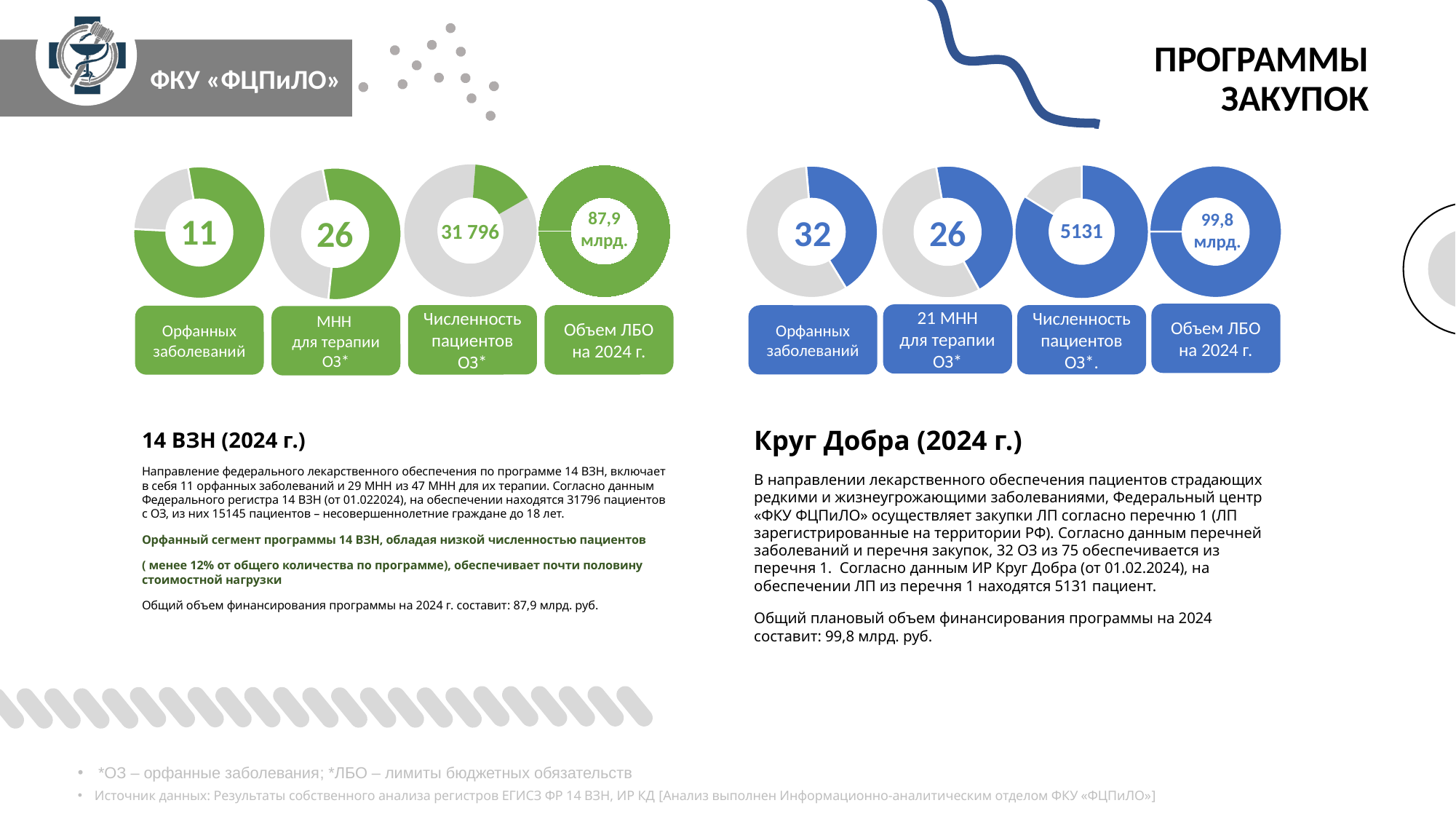
What kind of chart is used to display the values on this slide? Donut chart What is the difference between the 'Объем ЛБО на 2024 г.' values of the blue Круг Добра chart (99,8 млрд.) and the green 14 ВЗН chart (87,9 млрд.)? 11,9 млрд. In the green 14 ВЗН group, what value is shown in the 'Численность пациентов ОЗ' donut chart? 31 796 In the green 14 ВЗН group, what value is shown in the centre of the 'Орфанных заболеваний' donut chart? 11 Which program shows the larger 'Численность пациентов ОЗ' value, 14 ВЗН (green) or Круг Добра (blue)? 14 ВЗН (green) In the blue Круг Добра group, what value is shown in the 'Численность пациентов ОЗ' donut chart? 5131 In the blue Круг Добра group, what value is shown in the centre of the 'Орфанных заболеваний' donut chart? 32 In the green 14 ВЗН group, what value is shown in the 'Объем ЛБО на 2024 г.' donut chart? 87,9 млрд. What is the difference between the 'Орфанных заболеваний' values of the blue Круг Добра chart (32) and the green 14 ВЗН chart (11)? 21 How many donut charts are shown on the slide in total? 8 In the blue Круг Добра group, what value is shown in the 'Объем ЛБО на 2024 г.' donut chart? 99,8 млрд. Which program shows the larger 'Объем ЛБО на 2024 г.' value, 14 ВЗН (green) or Круг Добра (blue)? Круг Добра (blue)